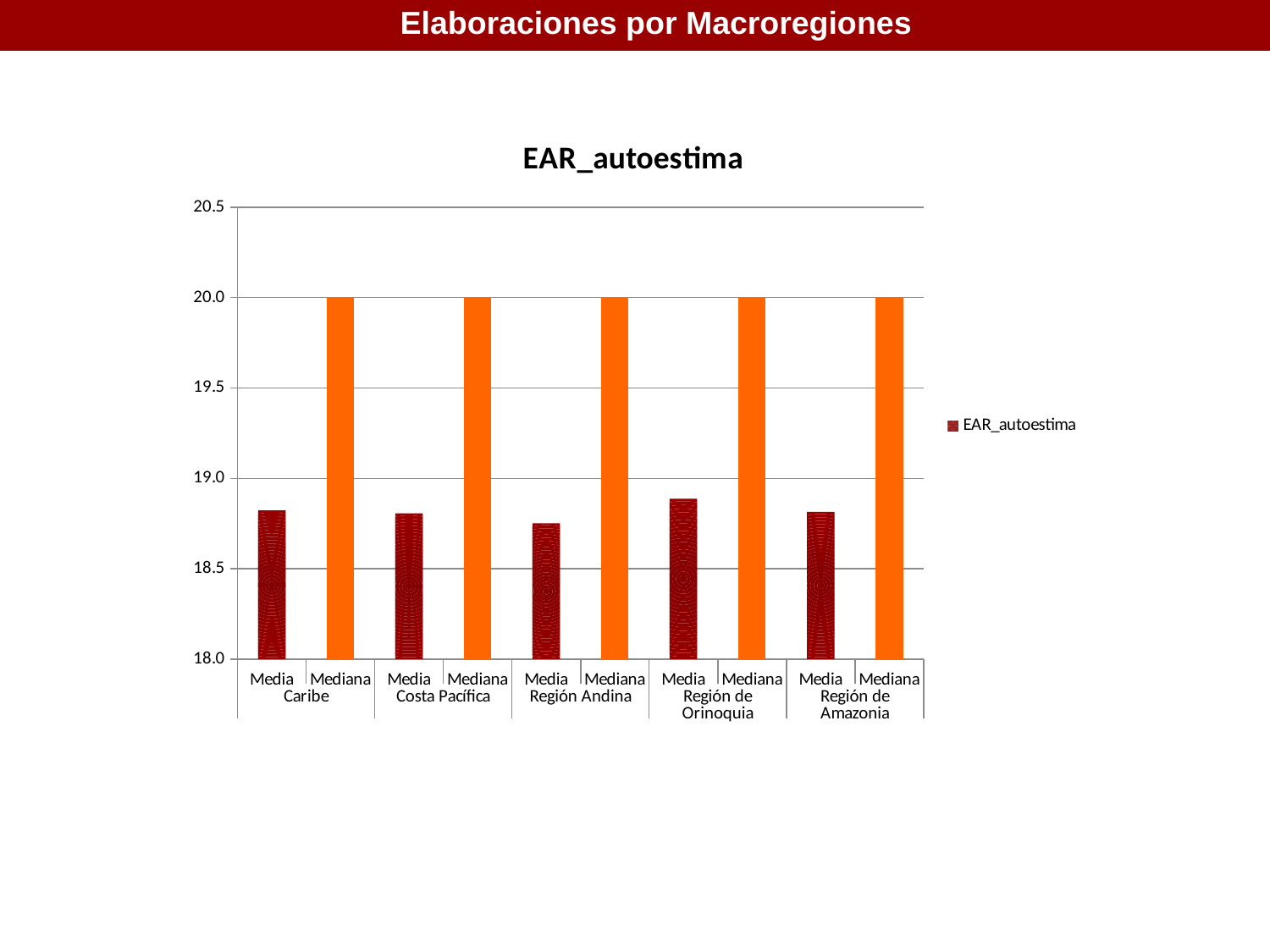
What is the Mediana value for Región de Amazonia? 20.0 What is the title of the chart? EAR_autoestima What colour are the Mediana bars? orange Is the Media value for Región de Orinoquia greater or less than 18.5? greater How many regions are shown along the x axis? 5 Which region has the lowest Media value? Región Andina Which is larger for Costa Pacífica, the Media or the Mediana? Mediana What is the Mediana value for Caribe? 20.0 How many series does the legend list? 1 What kind of chart is shown on the slide? bar chart Which region has the highest Media value? Región de Orinoquia Is the Media value for Caribe greater or less than 19.0? less